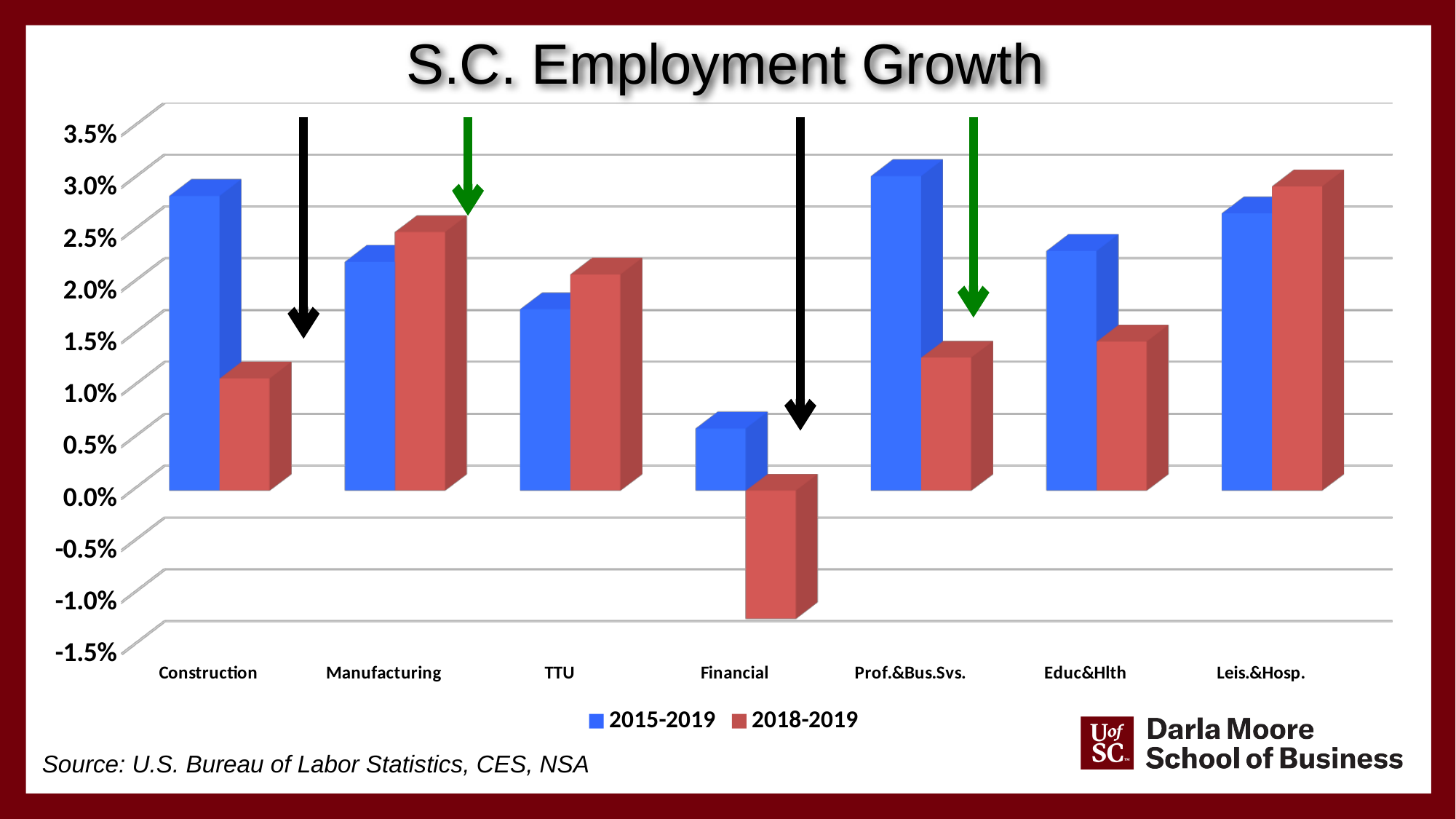
Which category has the lowest 2018-2019 value? Financial For Construction, which is larger: the 2015-2019 value or the 2018-2019 value? 2015-2019 What kind of chart is shown on the slide? Bar chart Which two periods are listed in the legend? 2015-2019 and 2018-2019 How many series does the legend list? 2 Is the 2018-2019 value for Financial greater or less than 0.0%? less How many industry categories are shown on the x axis? 7 Which category has the highest 2018-2019 value? Leis.&Hosp. Which category has the lowest 2015-2019 value? Financial What is the title of the chart? S.C. Employment Growth Is the 2018-2019 value for Prof.&Bus.Svs. greater or less than 2.0%? less Is the 2015-2019 value for Construction greater or less than 2.5%? greater